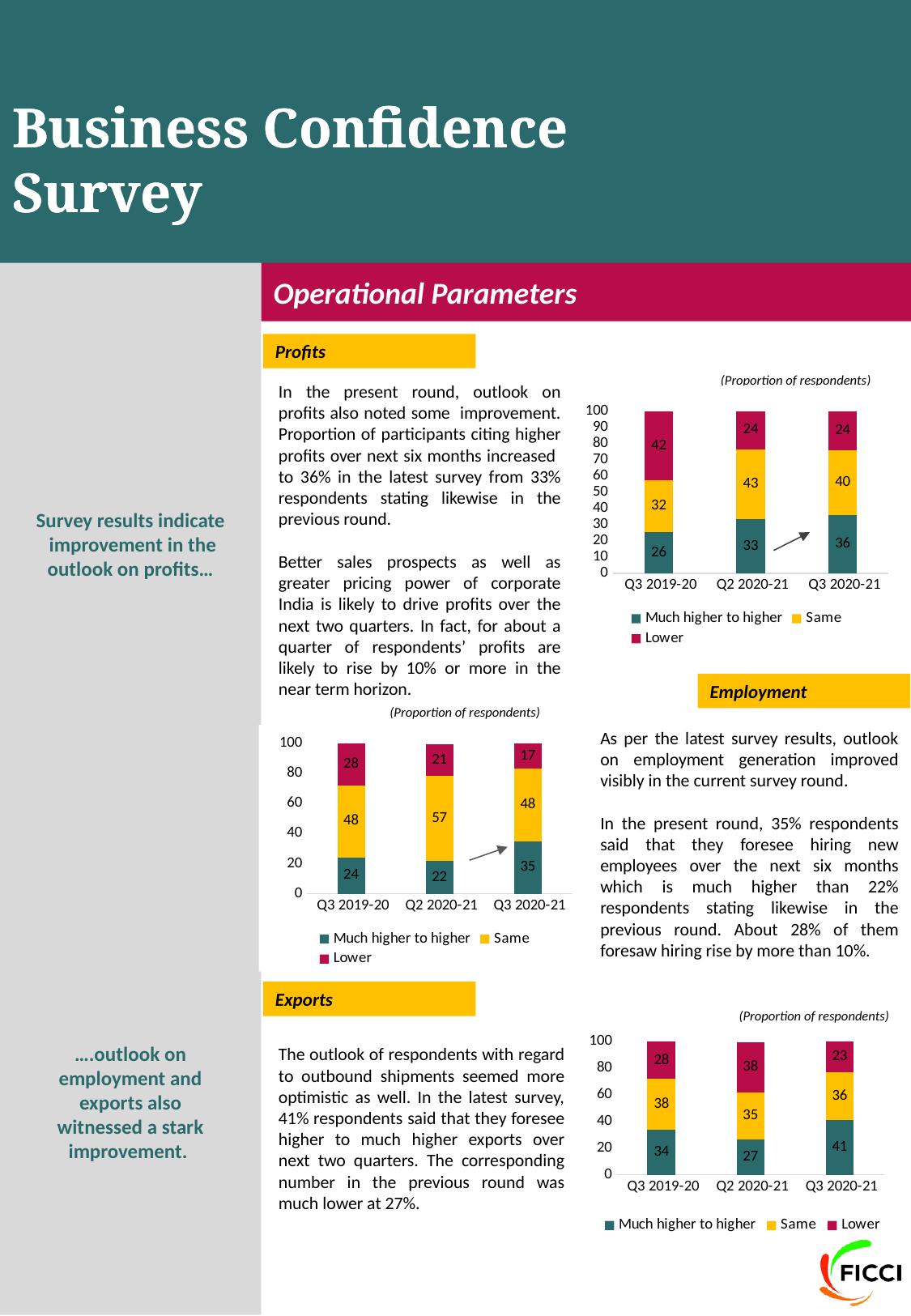
In the Employment chart (middle left), what is the value for 'Same' in Q2 2020-21? 57 In the Exports chart (bottom right), is the 'Same' value for Q3 2019-20 larger or smaller than the 'Same' value for Q2 2020-21? larger In the Profits chart (top right), how many series does the legend list? 3 In the Profits chart (top right), what is the total of the stacked bar for Q2 2020-21? 100 In the Profits chart (top right), what is the value for 'Much higher to higher' in Q3 2020-21? 36 In the Exports chart (bottom right), what is the value for 'Lower' in Q2 2020-21? 38 In the Employment chart (middle left), which quarter has the highest value for 'Much higher to higher'? Q3 2020-21 What type of chart is the Exports chart (bottom right)? stacked bar chart In the Profits chart (top right), what is the value for 'Lower' in Q3 2019-20? 42 In the Employment chart (middle left), what is the difference between the 'Much higher to higher' values for Q3 2020-21 and Q2 2020-21? 13 In the Employment chart (middle left), does the 'Lower' value rise or fall from Q3 2019-20 to Q3 2020-21? fall In the Exports chart (bottom right), which quarter has the lowest value for 'Much higher to higher'? Q2 2020-21